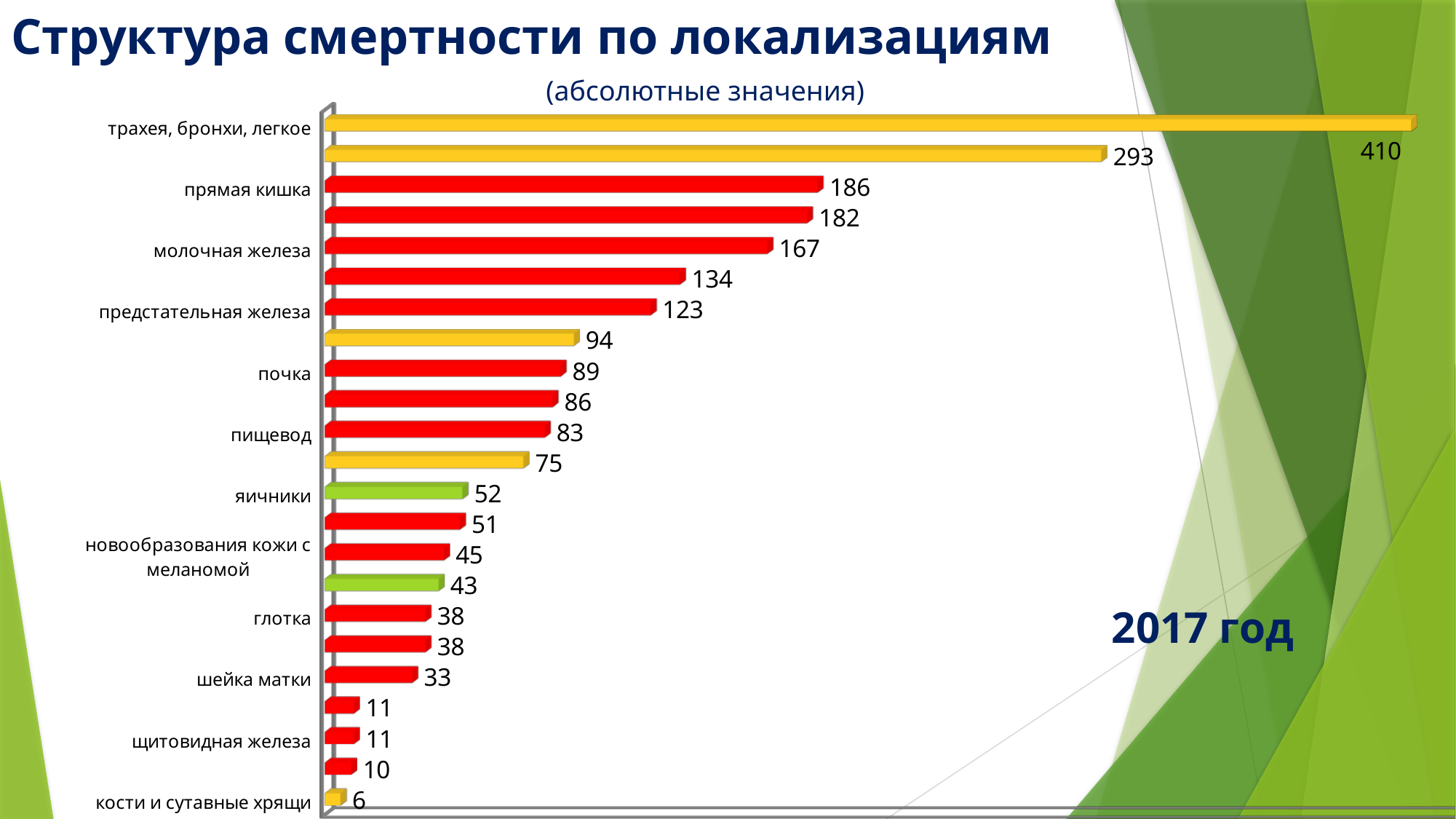
What is the value for предстательная железа? 123 What is the difference between the values for прямая кишка and молочная железа? 19 Which category has the highest value? трахея, бронхи, легкое Which is larger, the value for почка or the value for пищевод? почка What is the value for молочная железа? 167 What is the value for трахея, бронхи, легкое? 410 What is the value for яичники? 52 Which category has the lowest value? кости и сутавные хрящи What type of chart is shown on the slide? bar chart What is the value for прямая кишка? 186 What is the value for кости и суставные хрящи? 6 Which year is the chart data for, according to the slide? 2017 год